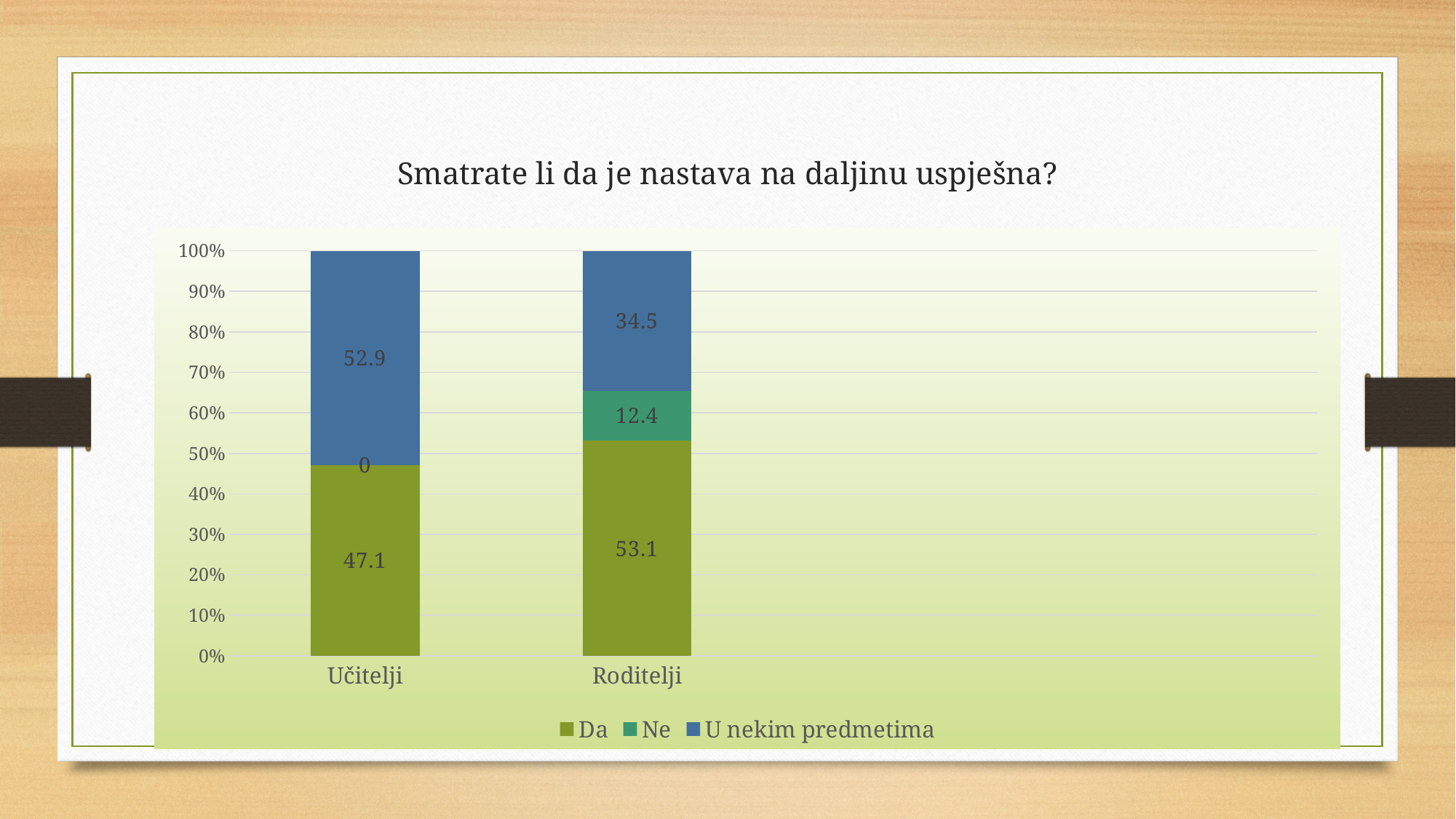
What is the value for "Da" for Učitelji? 47.1 What is the title of the chart? Smatrate li da je nastava na daljinu uspješna? How many categories are shown on the x axis? 2 What is the value for "U nekim predmetima" for Roditelji? 34.5 What is the value for "U nekim predmetima" for Učitelji? 52.9 What is the value for "Ne" for Učitelji? 0 What is the difference between the "U nekim predmetima" values for Učitelji and Roditelji? 18.4 Which category has the higher value for "U nekim predmetima", Učitelji or Roditelji? Učitelji How many series does the legend list? 3 What is the value for "Ne" for Roditelji? 12.4 What is the difference between the "Da" values for Roditelji and Učitelji? 6 Which category has the higher value for "Da", Učitelji or Roditelji? Roditelji